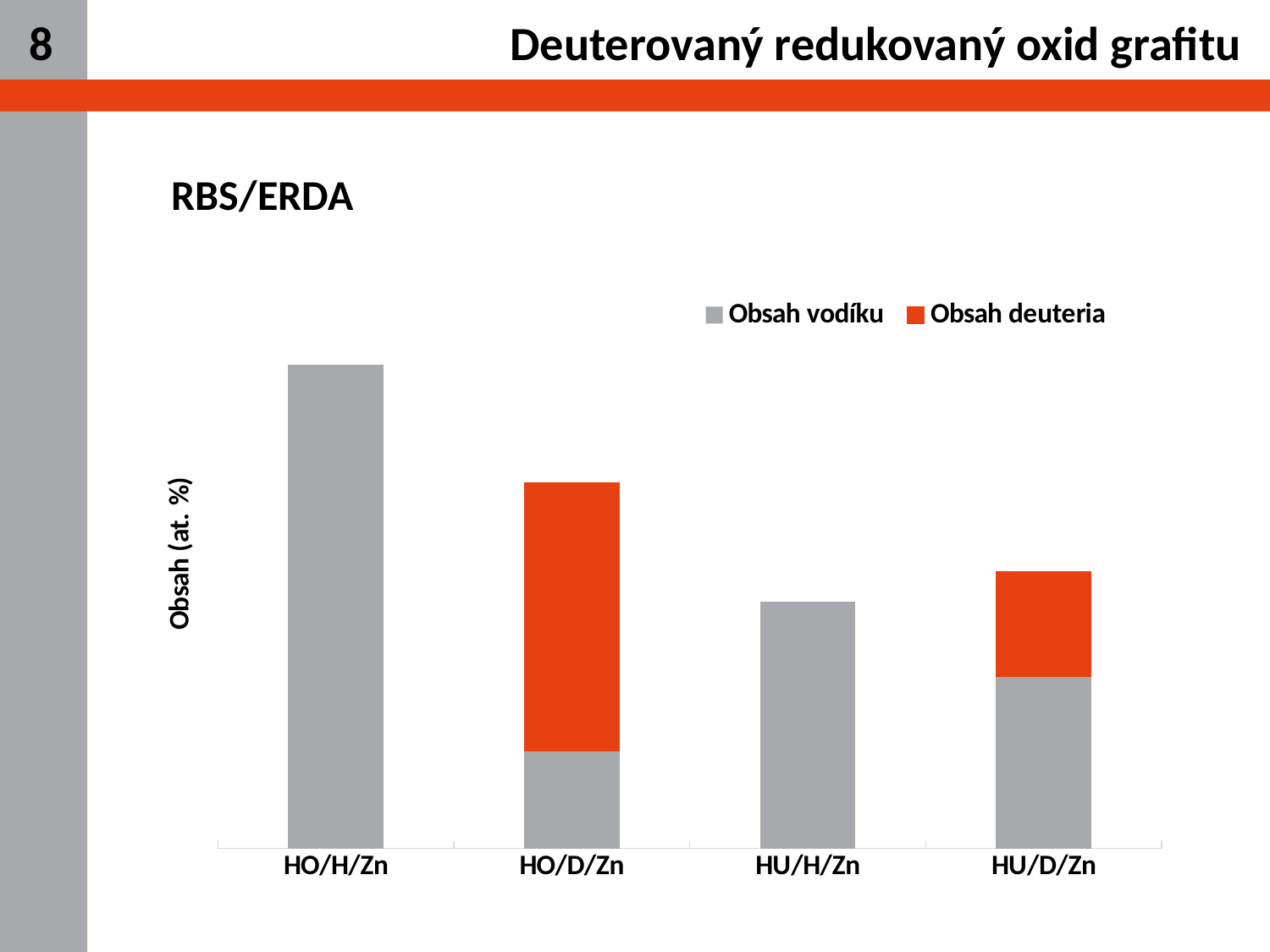
How many categories are shown on the x axis of the chart? 4 Which category has the largest Obsah vodíku (grey) segment? HO/H/Zn How many series does the chart legend list? 2 What kind of chart is shown on the slide? Stacked bar chart Which has the larger Obsah deuteria segment, HO/D/Zn or HU/D/Zn? HO/D/Zn Which has the larger Obsah vodíku segment, HO/H/Zn or HU/H/Zn? HO/H/Zn Which category has the smallest Obsah vodíku (grey) segment? HO/D/Zn Which category has the shortest bar overall in the chart? HU/H/Zn What is the label of the vertical axis of the chart? Obsah (at. %) Which colour represents Obsah deuteria in the chart legend? Orange-red How many categories in the chart show a non-zero Obsah deuteria segment? 2 Which category has the tallest bar overall in the chart? HO/H/Zn